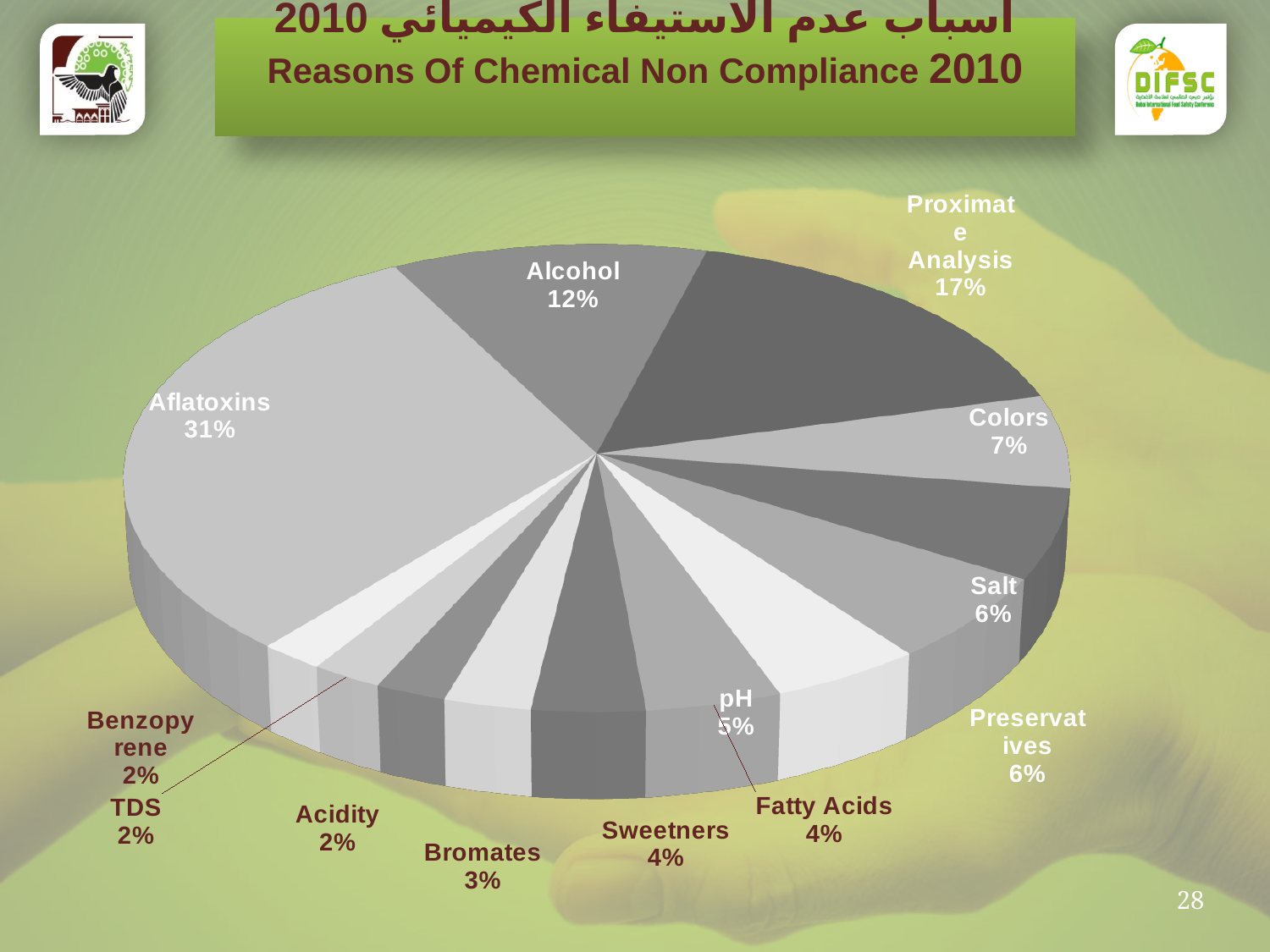
Which is larger, the share for Colors or the share for Salt? Colors How many categories are shown in the pie chart? 13 What is the difference in percentage points between Alcohol and pH? 7 What percentage is shown for Proximate Analysis? 17% What percentage is shown for Preservatives? 6% What is the difference in percentage points between Aflatoxins and Proximate Analysis? 14 What percentage is shown for Alcohol? 12% What percentage is shown for Bromates? 3% What is the title of the chart? Reasons Of Chemical Non Compliance 2010 What kind of chart is shown on the slide? Pie chart What share of the pie does Aflatoxins account for? 31% Which category has the largest slice of the pie? Aflatoxins